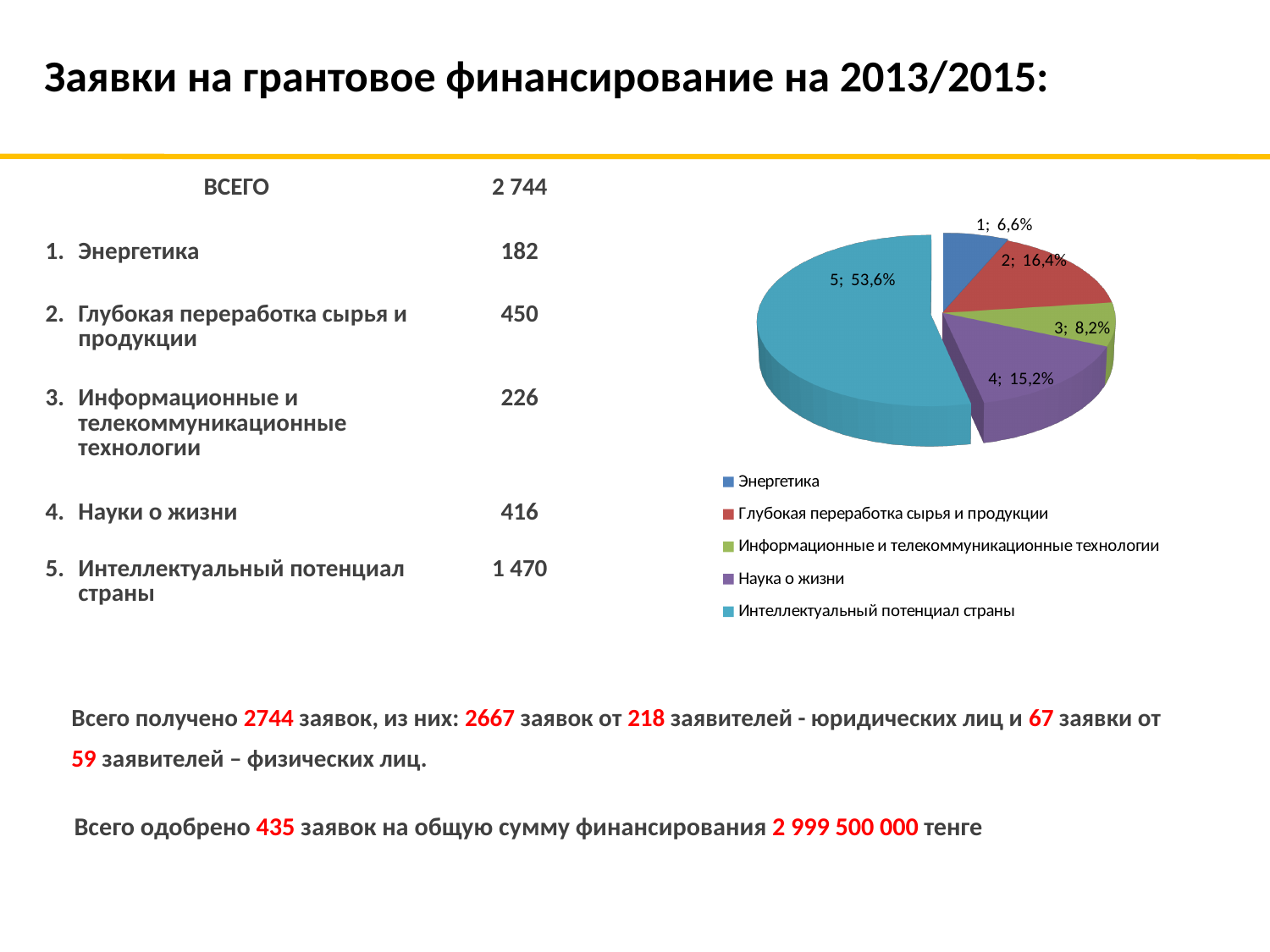
What share of the pie does Наука о жизни (slice 4) represent? 15,2% Which slice is larger: Глубокая переработка сырья и продукции or Наука о жизни? Глубокая переработка сырья и продукции Which category has the largest slice of the pie? Интеллектуальный потенциал страны What percentage is shown for the slice labelled 3 (Информационные и телекоммуникационные технологии)? 8,2% How many entries does the legend of the pie chart list? 5 How many slices does the pie chart have? 5 Which category has the smallest slice of the pie? Энергетика What kind of chart is shown on the slide? pie chart What colour is the slice for Интеллектуальный потенциал страны? light blue (cyan) What is the difference in percentage points between slice 2 (16,4%) and slice 1 (6,6%)? 9,8% What percentage is shown for the slice labelled 2 (Глубокая переработка сырья и продукции)? 16,4% What share of the pie does the slice for Энергетика represent? 6,6%